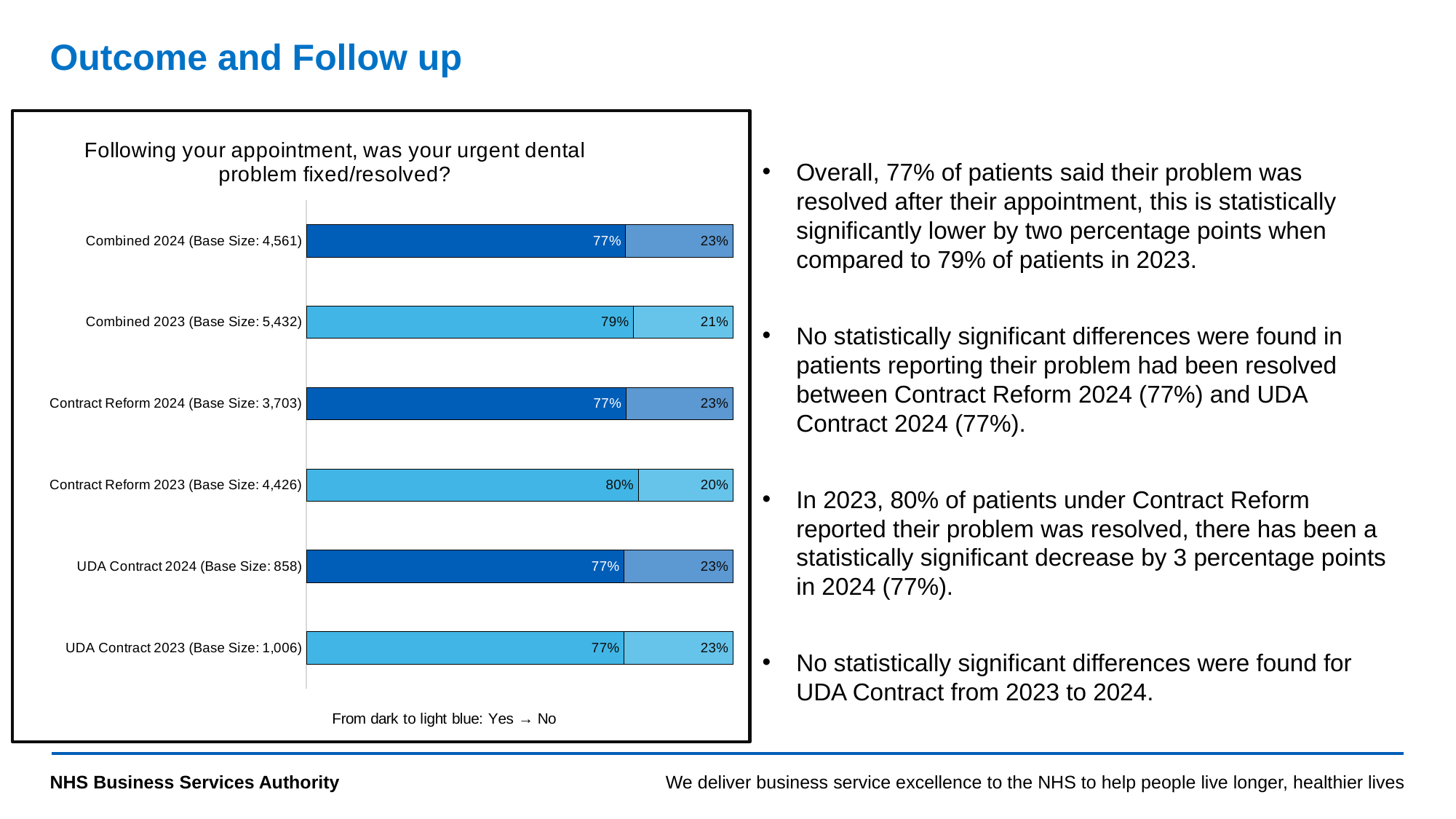
What percentage of Combined 2023 respondents said No? 21% Which has a larger Yes percentage, Combined 2023 or Combined 2024? Combined 2023 What percentage of Combined 2024 respondents said Yes, their urgent dental problem was fixed/resolved? 77% What is the difference in Yes percentage between Contract Reform 2023 and Contract Reform 2024? 3 percentage points What is the base size shown for Combined 2024? 4,561 Which category has the highest Yes percentage? Contract Reform 2023 (Base Size: 4,426) What type of chart is shown on the slide? Stacked bar chart Which category has the lowest No percentage? Contract Reform 2023 (Base Size: 4,426) What is the Yes percentage for Contract Reform 2023? 80% How many categories (bars) are shown in the chart? 6 What is the No percentage for UDA Contract 2024? 23% What is the total of the Yes and No segments for the UDA Contract 2023 bar? 100%